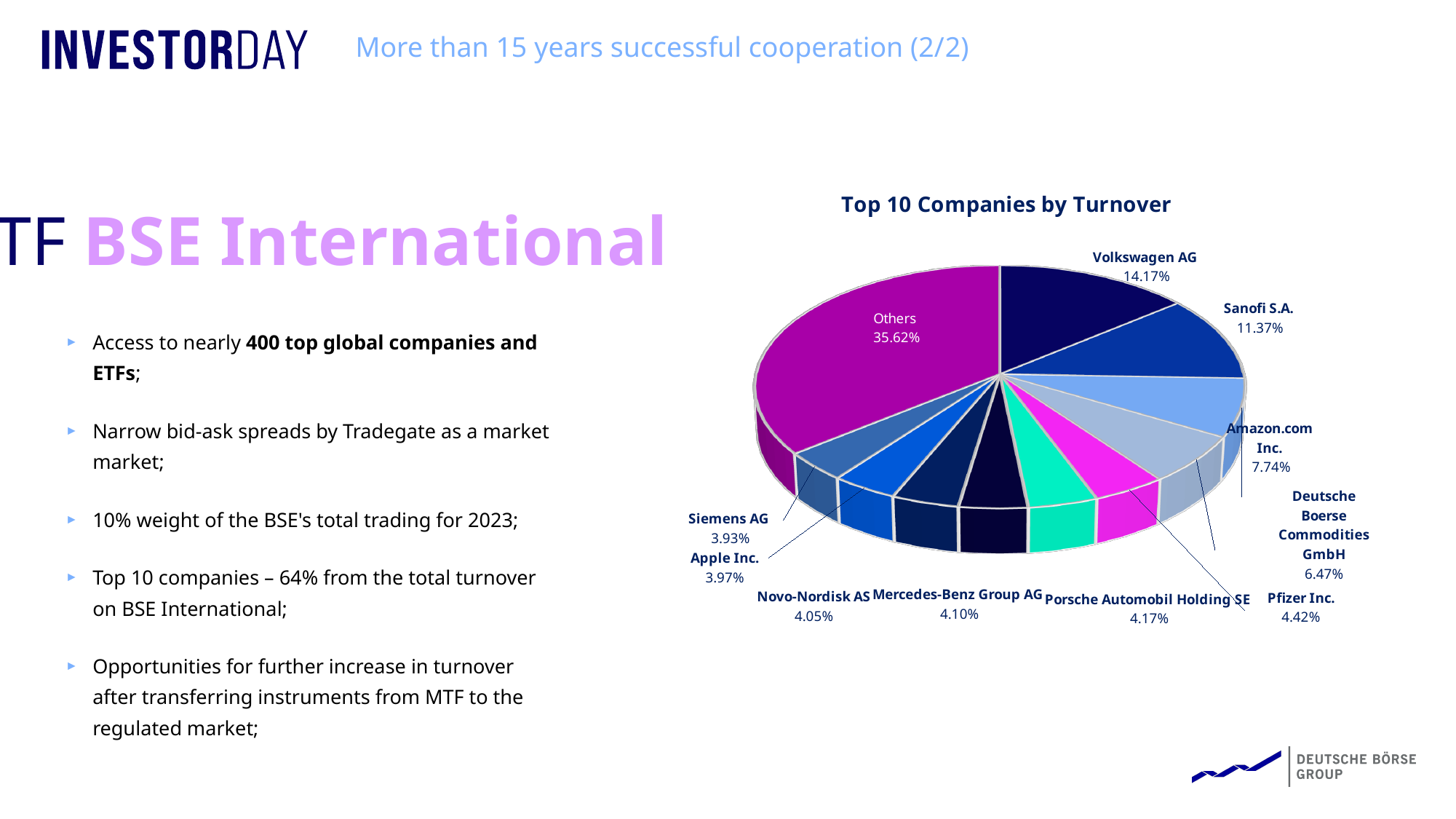
Which named company has the smallest share in the pie? Siemens AG What share of the pie is labelled Others? 35.62% Which slice of the pie is the largest? Others Which has a larger share, Pfizer Inc. or Porsche Automobil Holding SE? Pfizer Inc. What is the title of the chart? Top 10 Companies by Turnover What is the difference between the shares of Volkswagen AG and Sanofi S.A.? 2.80% What type of chart is shown on the slide? pie chart What percentage is shown for Deutsche Boerse Commodities GmbH? 6.47% What is the value for Amazon.com Inc.? 7.74% How many slices does the pie chart have? 11 What share of turnover does Volkswagen AG have? 14.17% What is the value shown for Sanofi S.A.? 11.37%